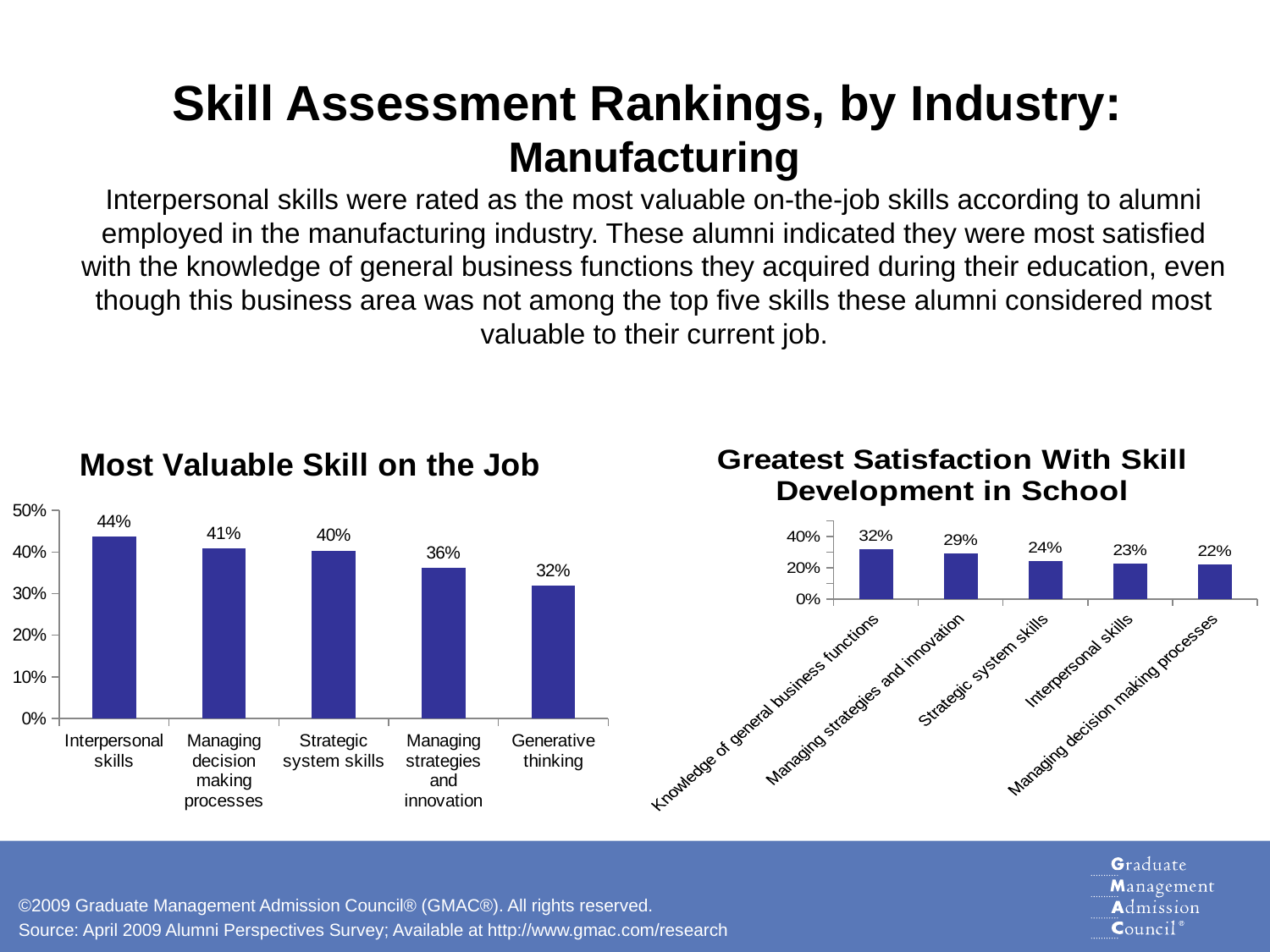
In the 'Most Valuable Skill on the Job' chart, how many categories are shown? 5 In the 'Most Valuable Skill on the Job' chart, what is the value for Managing strategies and innovation? 36% In the 'Most Valuable Skill on the Job' chart, what is the difference between Interpersonal skills and Generative thinking? 12% In the 'Most Valuable Skill on the Job' chart, what is the value for Interpersonal skills? 44% In the 'Greatest Satisfaction With Skill Development in School' chart, what is the value for Interpersonal skills? 23% In the 'Greatest Satisfaction With Skill Development in School' chart, what is the value for Knowledge of general business functions? 32% What kind of chart is the 'Most Valuable Skill on the Job' chart? bar chart In the 'Most Valuable Skill on the Job' chart, do the values rise or fall from left to right? fall In the 'Greatest Satisfaction With Skill Development in School' chart, what is the difference between Managing strategies and innovation and Managing decision making processes? 7% In the 'Greatest Satisfaction With Skill Development in School' chart, which is larger: Strategic system skills or Managing decision making processes? Strategic system skills In the 'Greatest Satisfaction With Skill Development in School' chart, which category has the highest value? Knowledge of general business functions In the 'Most Valuable Skill on the Job' chart, which category has the lowest value? Generative thinking